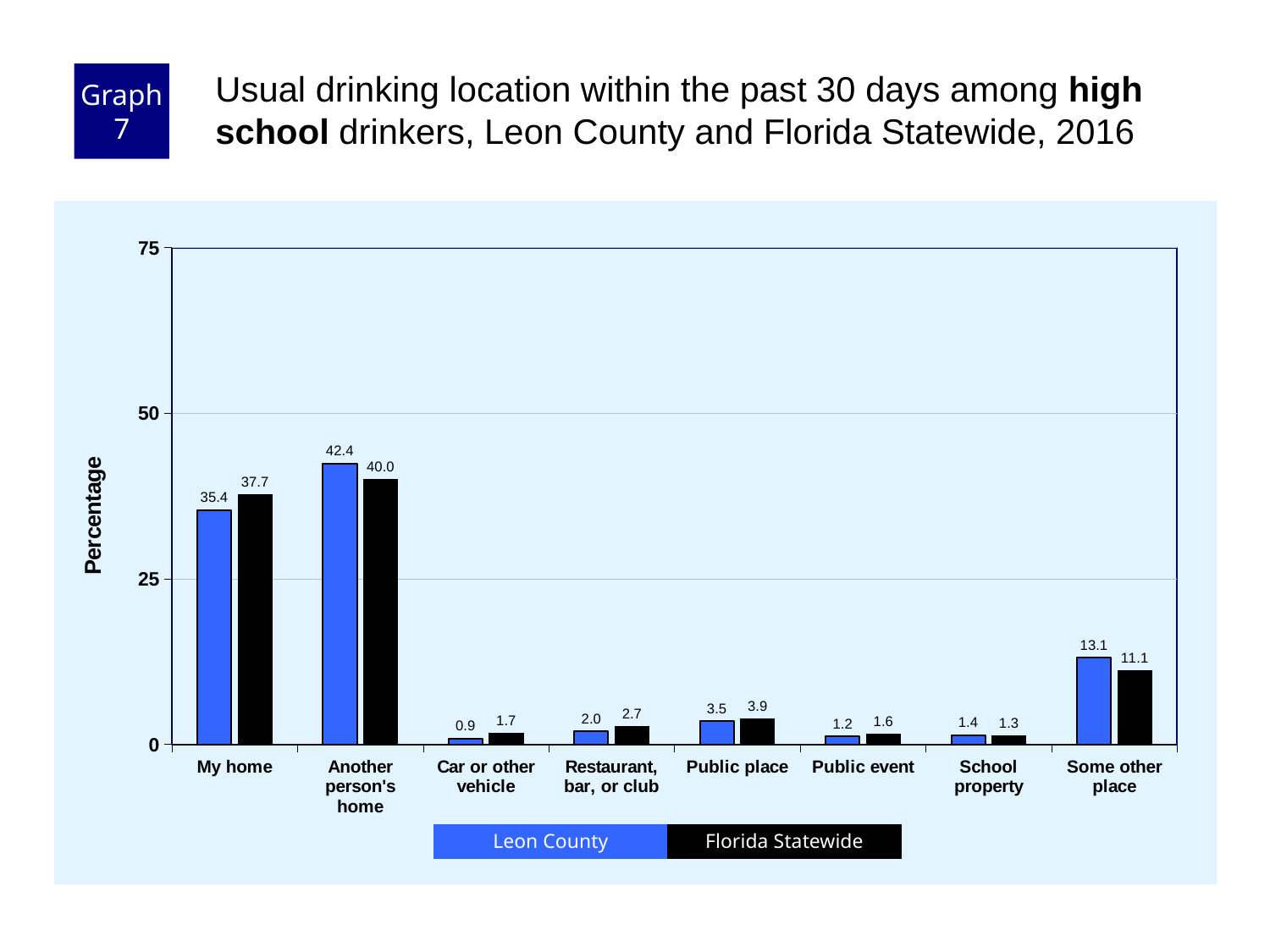
What is the Florida Statewide value for "My home"? 37.7 What is the Leon County value for "Some other place"? 13.1 What colour are the Florida Statewide bars? Black Is the Leon County value for "My home" greater or less than 25? greater What is the difference between the Leon County and Florida Statewide values for "Another person's home"? 2.4 What is the Leon County value for "Another person's home"? 42.4 How many series does the legend list? 2 How many drinking location categories are shown on the x axis? 8 Which category has the highest Florida Statewide value? Another person's home Which category has the lowest Leon County value? Car or other vehicle What kind of chart is shown on the slide? Bar chart Which is larger for "Some other place": Leon County or Florida Statewide? Leon County